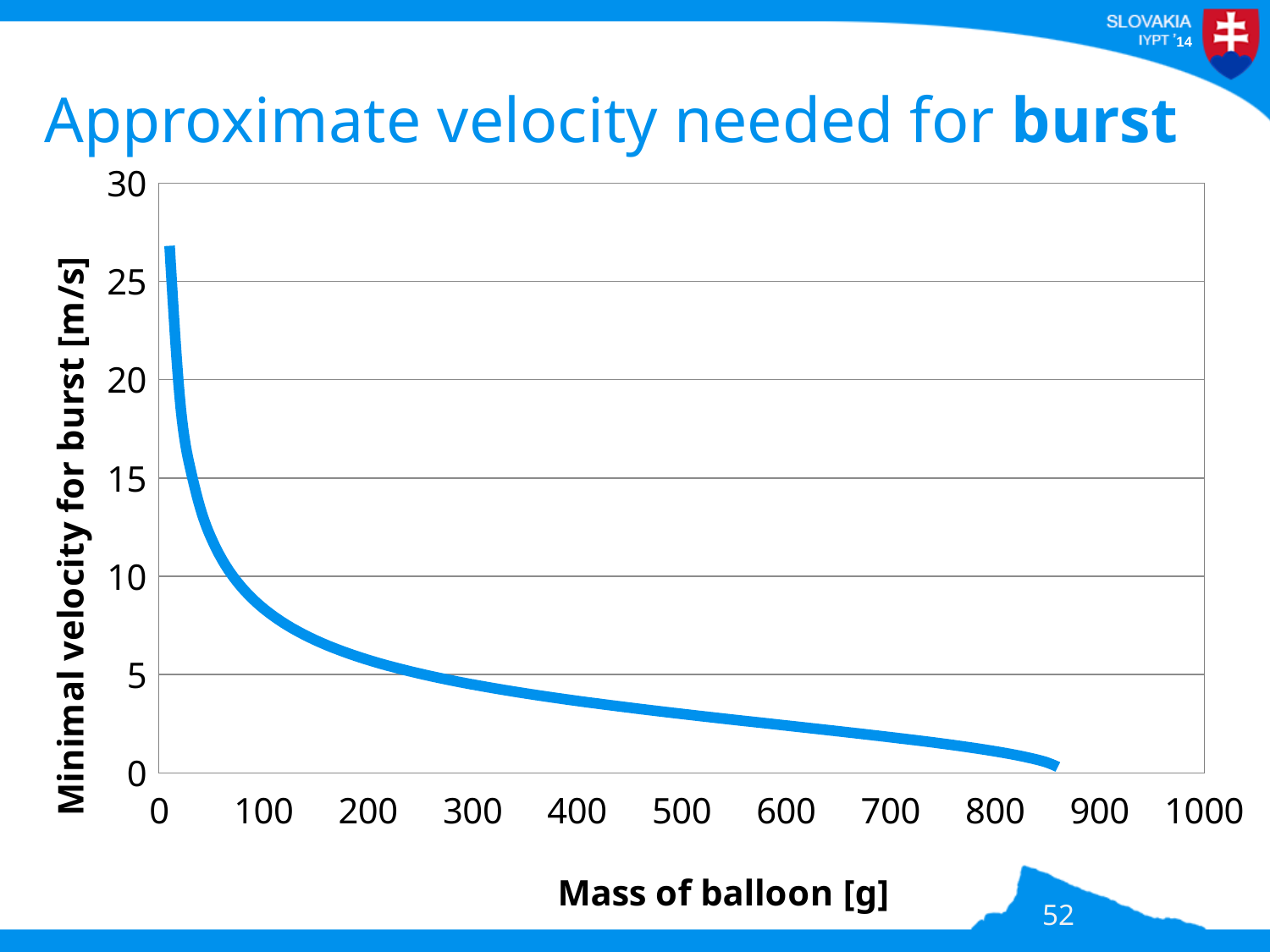
Does the minimal velocity for burst rise or fall as the mass of balloon increases? fall What is the highest value shown on the y axis? 30 Which mass has the higher minimal velocity for burst, 100 g or 600 g? 100 g Is the minimal velocity for burst at a mass of 300 g greater or less than 10 m/s? less Is the minimal velocity for burst at a mass of 200 g greater or less than 5 m/s? greater What is the label of the x axis? Mass of balloon [g] What is the title of the chart on the slide? Approximate velocity needed for burst Is the minimal velocity for burst at a mass of 500 g greater or less than 5 m/s? less What kind of chart is shown on the slide? line chart